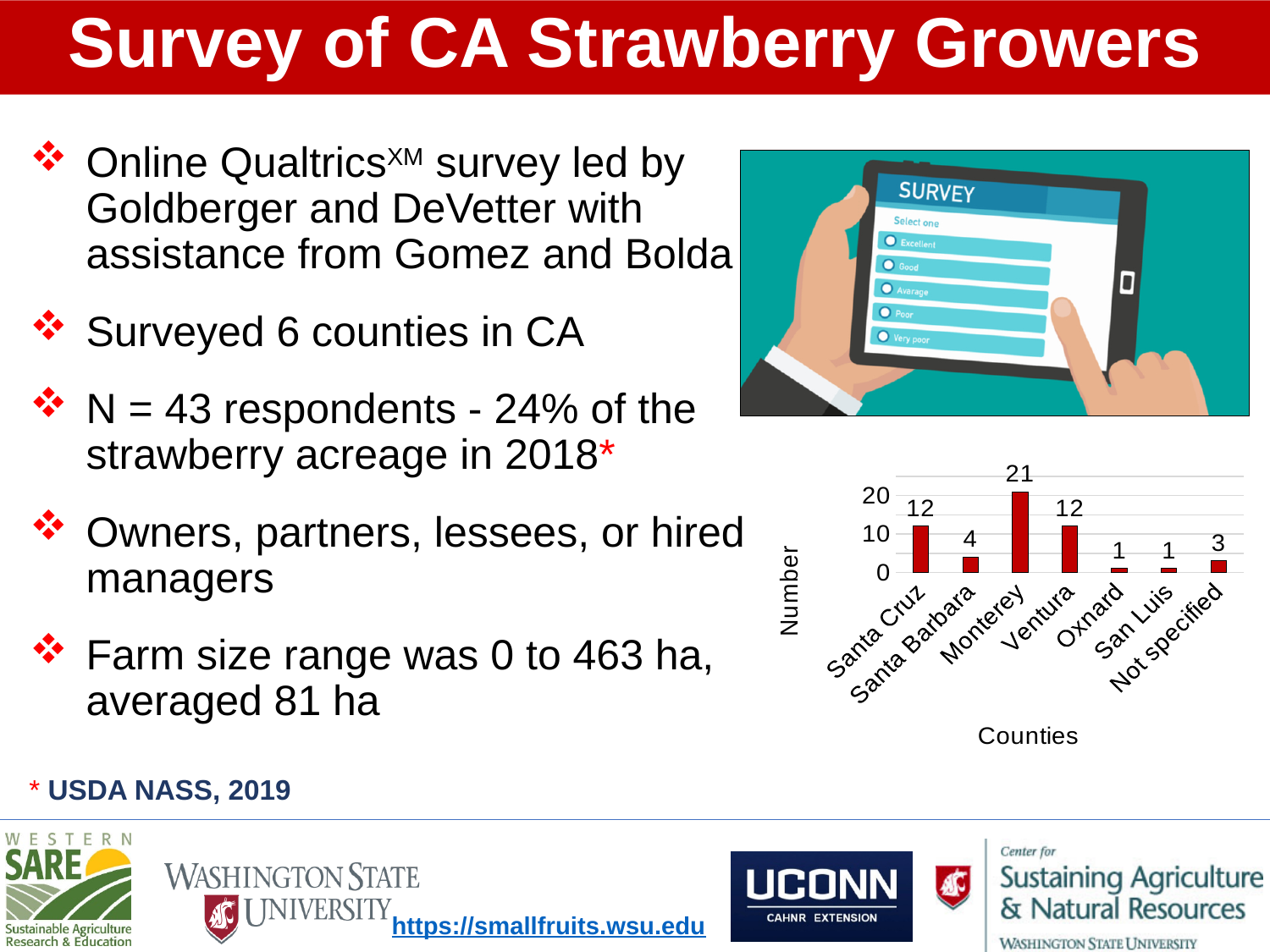
How many categories are shown on the x axis of the bar chart? 7 What kind of chart is shown on the slide? bar chart What is the difference between the values for Monterey and Santa Cruz? 9 What is the label of the y axis of the bar chart? Number Is the value for Monterey greater or less than 20? greater What is the value for Not specified in the bar chart? 3 What is the value for Monterey in the bar chart? 21 Which is larger in the bar chart, Santa Barbara or Not specified? Santa Barbara What is the label of the x axis of the bar chart? Counties What is the difference between the values for Ventura and Santa Barbara? 8 What is the value for Santa Barbara in the bar chart? 4 Which county has the highest value in the bar chart? Monterey